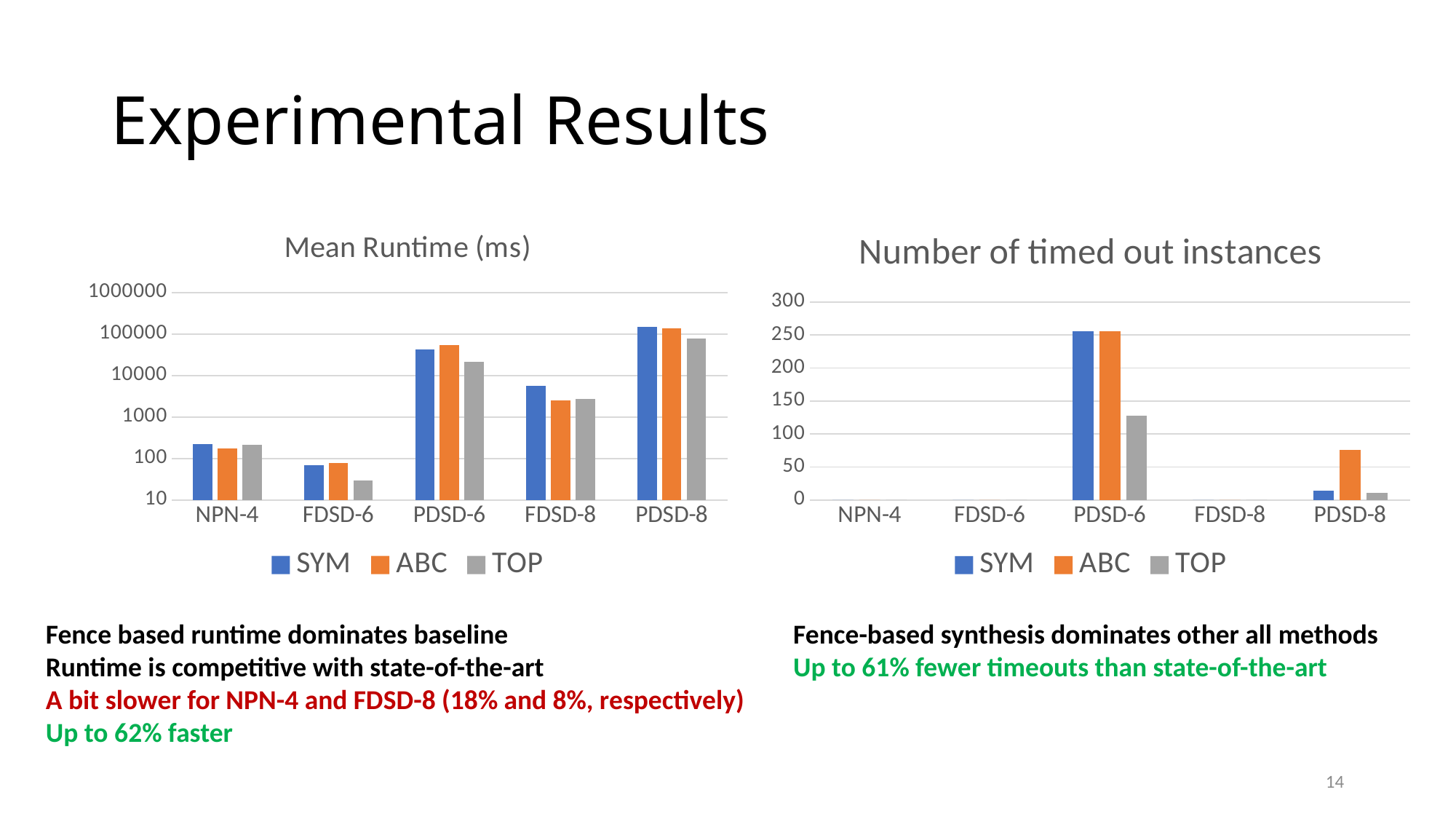
In the "Mean Runtime (ms)" chart, is the TOP value for FDSD-6 greater or less than 100? less In the "Number of timed out instances" chart, is the TOP value for PDSD-6 greater or less than 100? greater In the "Mean Runtime (ms)" chart, for PDSD-6, which is larger: SYM or TOP? SYM In the "Mean Runtime (ms)" chart, is the SYM value for PDSD-8 greater or less than 100000? greater In the "Mean Runtime (ms)" chart, which category has the highest SYM value? PDSD-8 How many categories are shown on the x axis of the "Number of timed out instances" chart? 5 In the "Number of timed out instances" chart, which category has the highest ABC value? PDSD-6 What kind of chart is the "Mean Runtime (ms)" chart? bar chart How many series does the legend of the "Mean Runtime (ms)" chart list? 3 In the "Mean Runtime (ms)" chart, which category has the lowest TOP value? FDSD-6